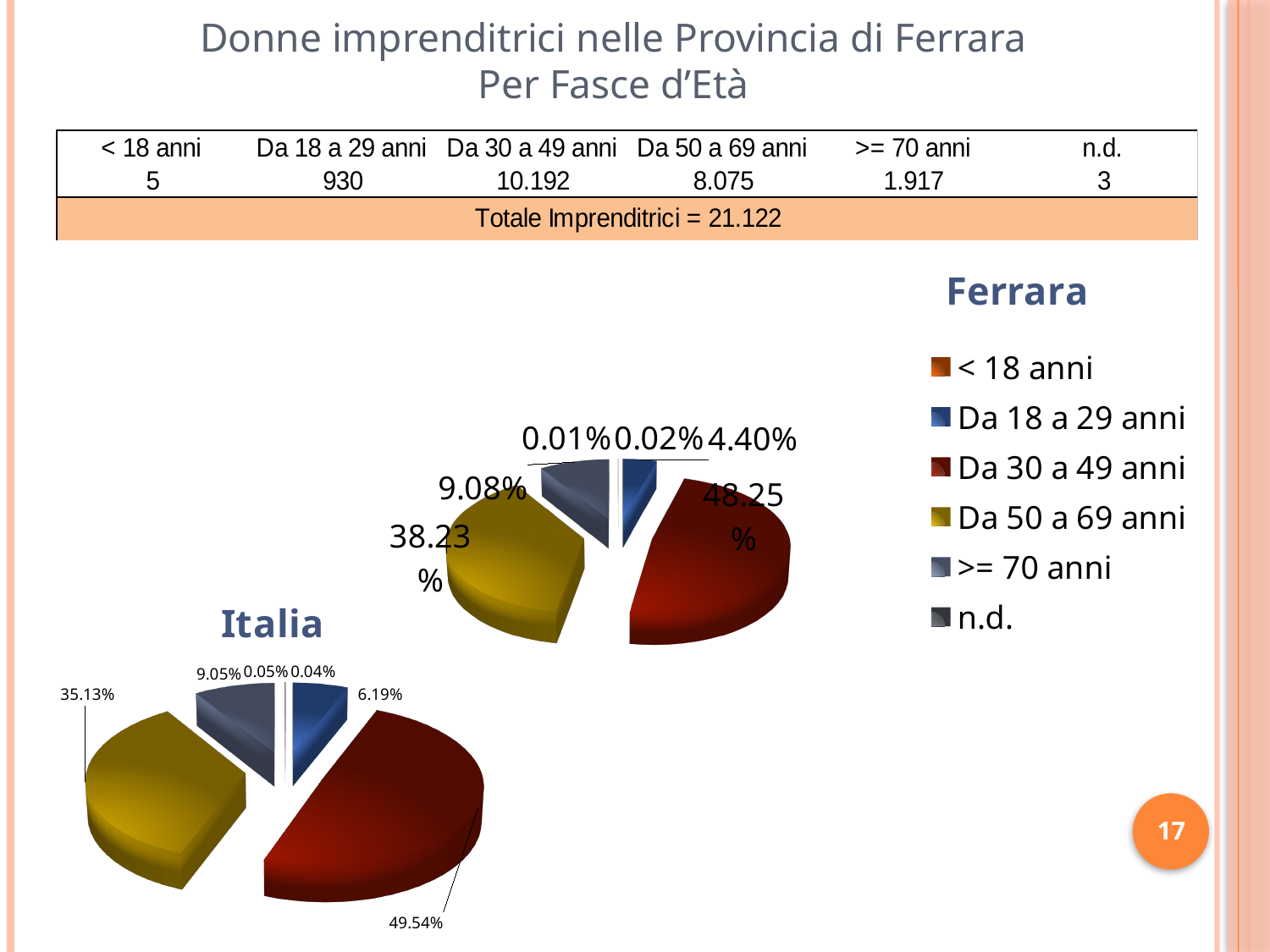
On the Italia pie chart, what share is shown for the Da 50 a 69 anni slice? 35.13% On the Ferrara pie chart, what share is shown for the Da 50 a 69 anni slice? 38.23% On the Ferrara pie chart, which age group has the largest slice? Da 30 a 49 anni On the Ferrara pie chart, what share is shown for the Da 30 a 49 anni slice? 48.25% Which is larger: the >= 70 anni share on the Ferrara pie chart or the >= 70 anni share on the Italia pie chart? Ferrara On the Italia pie chart, which age group has the largest slice? Da 30 a 49 anni How many entries does the legend of the Ferrara pie chart list? 6 On the Ferrara pie chart, what is the difference between the Da 30 a 49 anni share and the Da 50 a 69 anni share? 10.02%